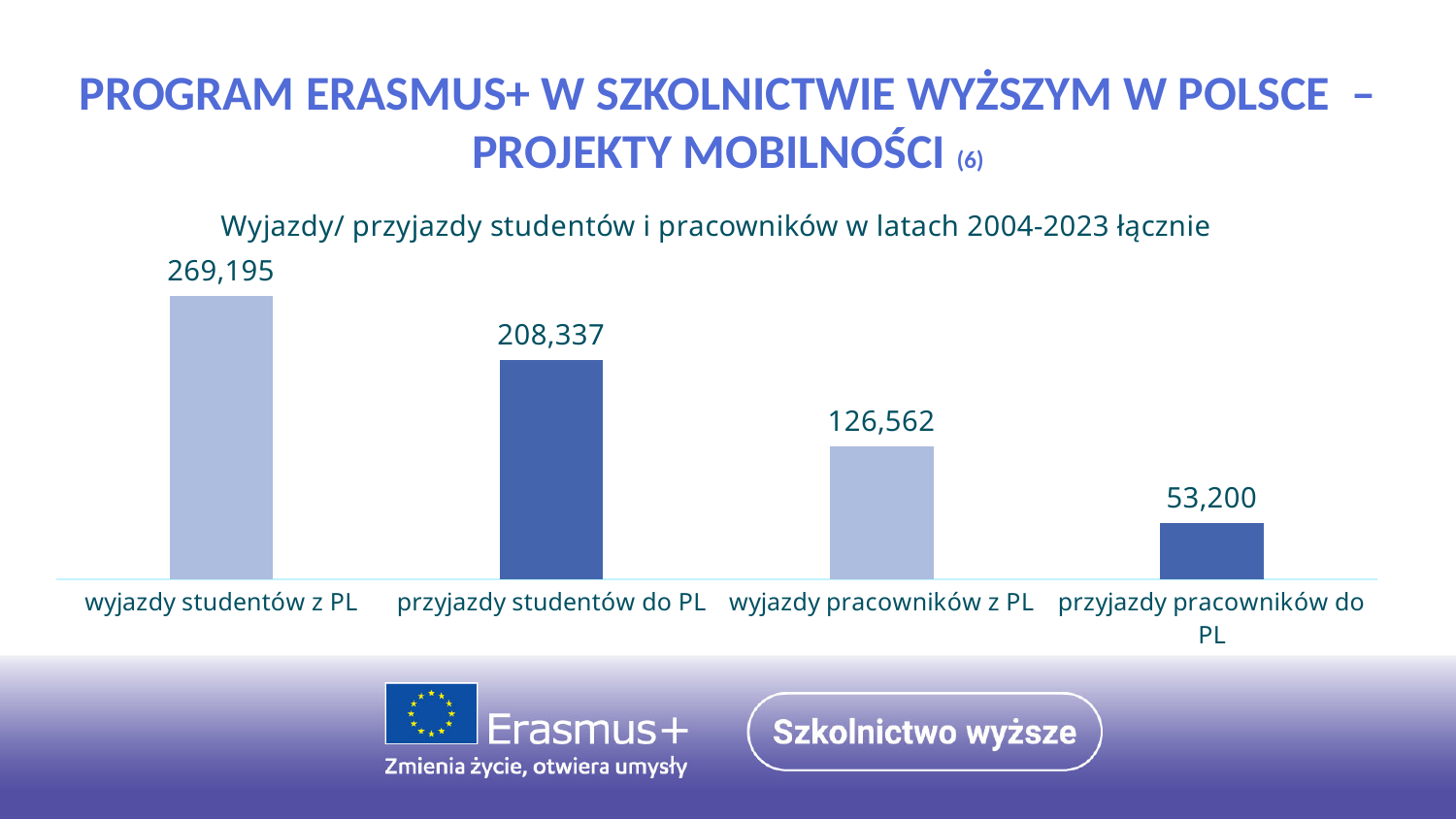
Which is larger: 'przyjazdy studentów do PL' or 'wyjazdy pracowników z PL'? przyjazdy studentów do PL Which category has the lowest value? przyjazdy pracowników do PL What is the value for 'przyjazdy pracowników do PL'? 53,200 What is the title of the chart? Wyjazdy/ przyjazdy studentów i pracowników w latach 2004-2023 łącznie What is the difference between 'wyjazdy pracowników z PL' and 'przyjazdy pracowników do PL'? 73,362 What is the value for 'wyjazdy pracowników z PL'? 126,562 What is the value for 'wyjazdy studentów z PL'? 269,195 Which category has the highest value? wyjazdy studentów z PL What kind of chart is shown on the slide? bar chart What is the value for 'przyjazdy studentów do PL'? 208,337 What is the difference between 'wyjazdy studentów z PL' and 'przyjazdy studentów do PL'? 60,858 How many categories are shown in the chart? 4